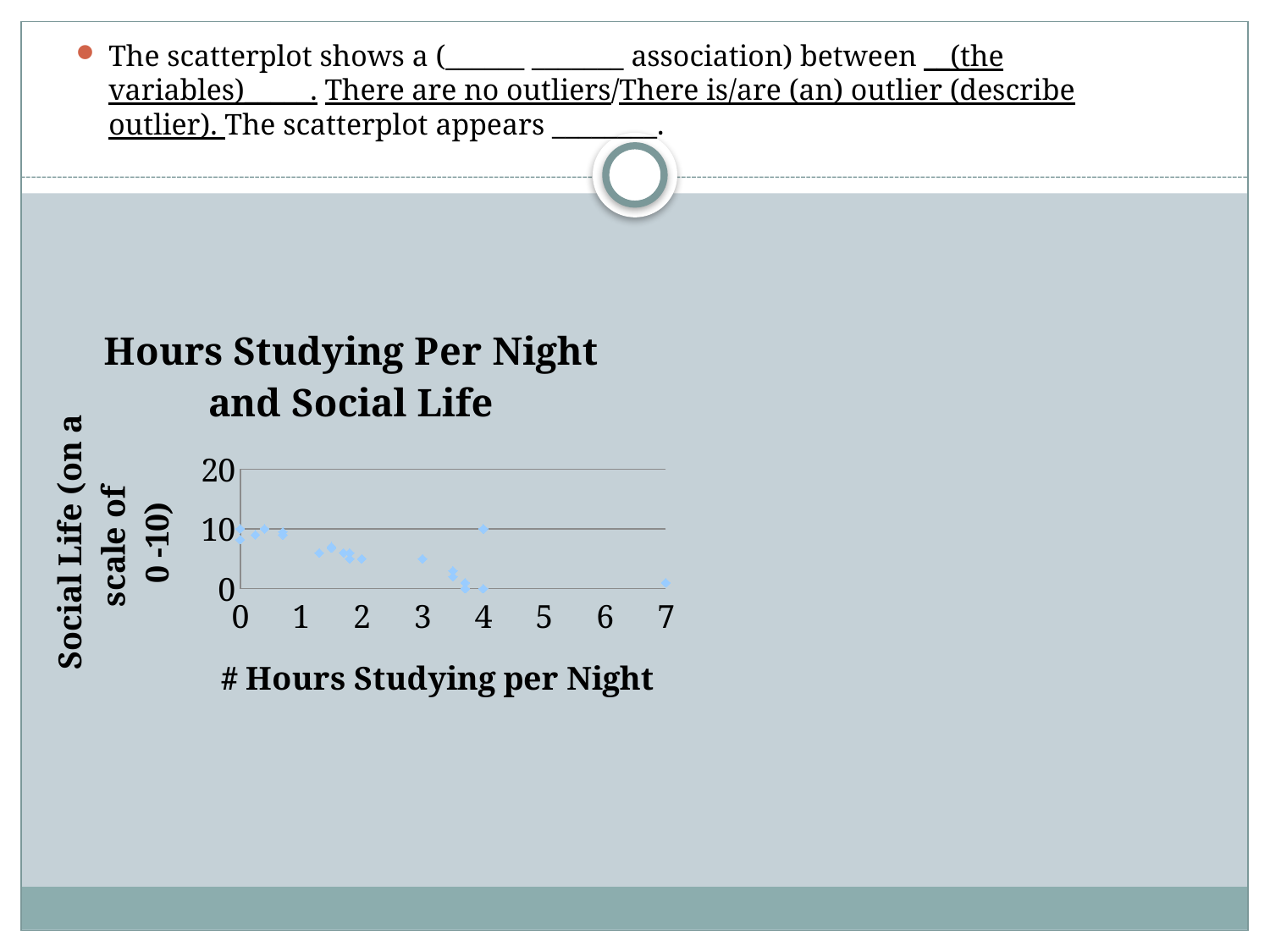
What is the title of the chart? Hours Studying Per Night and Social Life Which has a higher social life value: the point at 3 hours studying or the point at 7 hours studying? 3 hours studying Is the social life value for the point at 3 hours studying greater or less than 10? Less What kind of chart is shown on the slide? Scatter plot As the number of hours studying per night increases, do the social life values generally rise or fall? Fall Is the social life value for the point at 7 hours studying greater or less than 10? Less Which has a higher social life value: the point at 0 hours studying or the point at 7 hours studying? 0 hours studying Is the social life value for the point at 7 hours studying greater or less than 5? Less What is the label on the x axis of the chart? # Hours Studying per Night